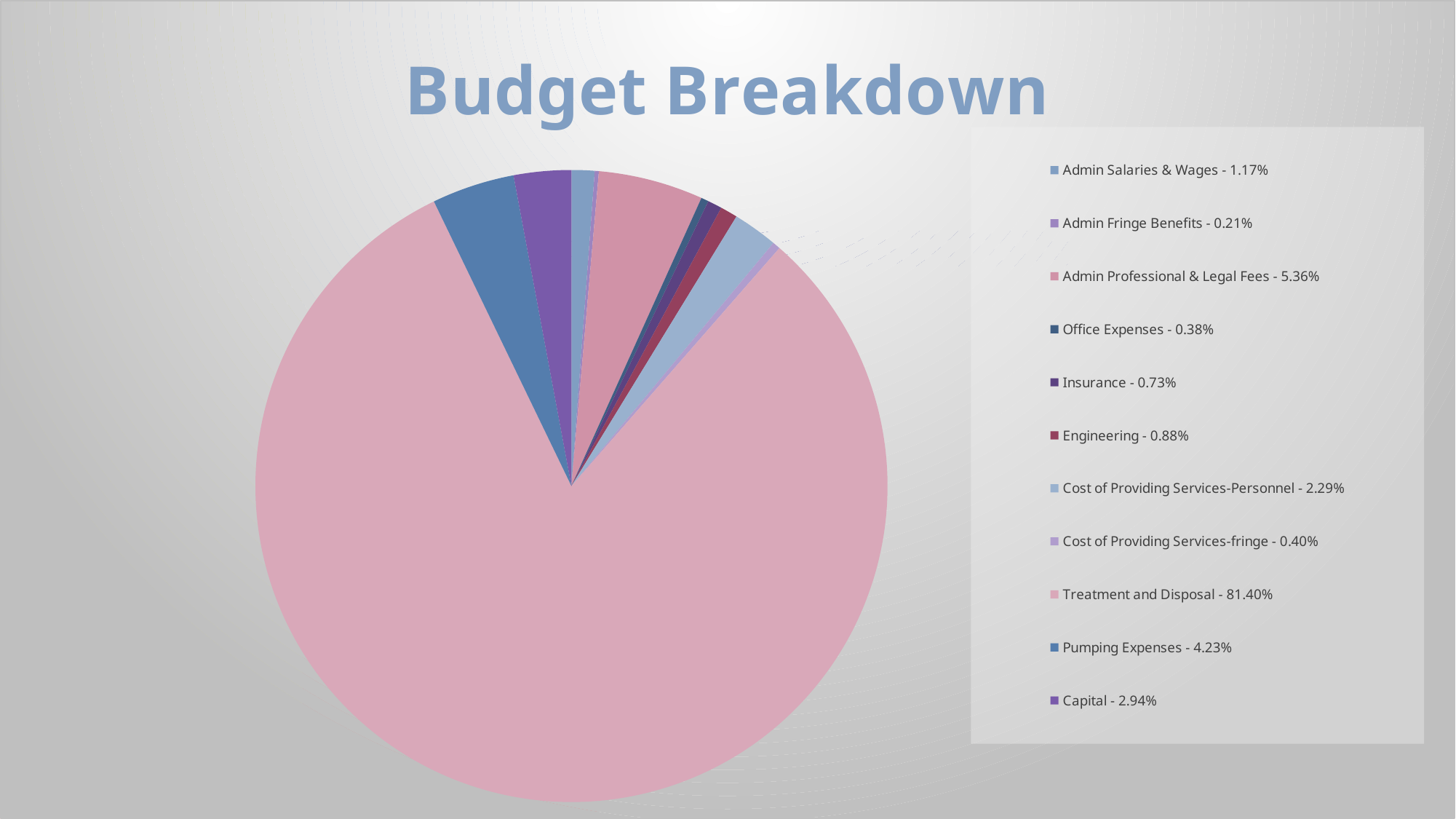
What is the title of the chart? Budget Breakdown What percentage is shown for Pumping Expenses? 4.23% Which is larger, the share for Capital or the share for Cost of Providing Services-Personnel? Capital What is the combined share of Admin Salaries & Wages and Admin Fringe Benefits? 1.38% What is the difference between the shares for Admin Professional & Legal Fees and Pumping Expenses? 1.13% How many categories does the legend list? 11 Which category has the largest share of the budget? Treatment and Disposal What percentage is shown for Engineering? 0.88% What kind of chart is shown on the slide? Pie chart What percentage is shown for Admin Professional & Legal Fees? 5.36% What share of the budget is Treatment and Disposal? 81.40% Which category has the smallest share of the budget? Admin Fringe Benefits